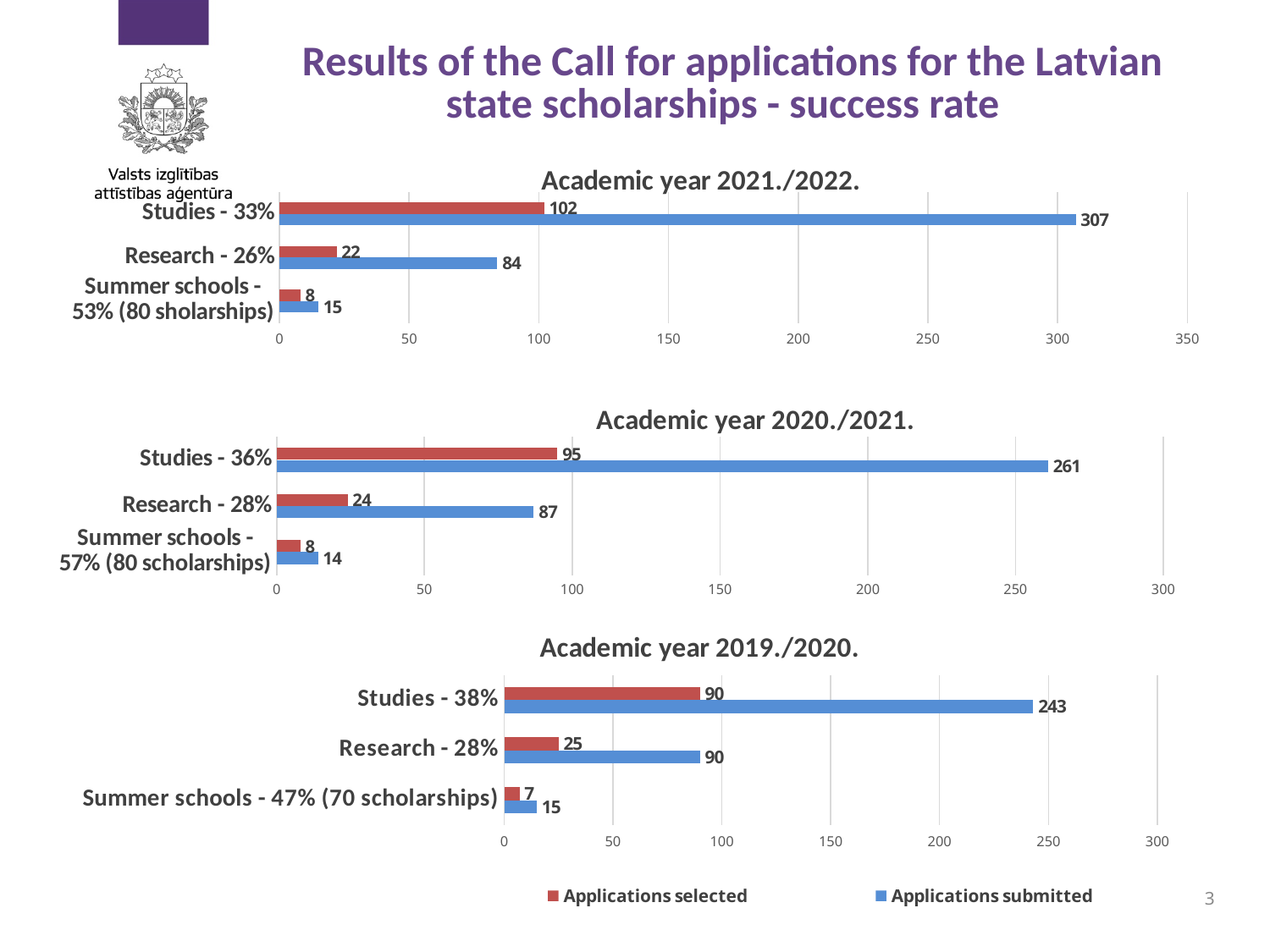
In the 'Academic year 2021./2022.' chart, how many applications were selected for Research? 22 How many categories are shown in the 'Academic year 2021./2022.' chart? 3 In the 'Academic year 2019./2020.' chart, how many applications were selected for Summer schools? 7 In the 'Academic year 2019./2020.' chart, which category has the highest number of applications submitted? Studies - 38% In the 'Academic year 2020./2021.' chart, how many applications were submitted for Research? 87 In the 'Academic year 2020./2021.' chart, which category has the lowest number of applications selected? Summer schools - 57% (80 scholarships) In the 'Academic year 2021./2022.' chart, how many applications were submitted for Studies? 307 In the 'Academic year 2020./2021.' chart, is the value for applications submitted for Studies greater or less than 250? greater In the 'Academic year 2021./2022.' chart, what is the difference between applications submitted and applications selected for Studies? 205 How many series does the legend at the bottom of the slide list? 2 What type of chart is the 'Academic year 2019./2020.' chart? Bar chart In the 'Academic year 2019./2020.' chart, which is larger: applications submitted for Research or applications selected for Studies? They are equal (90)